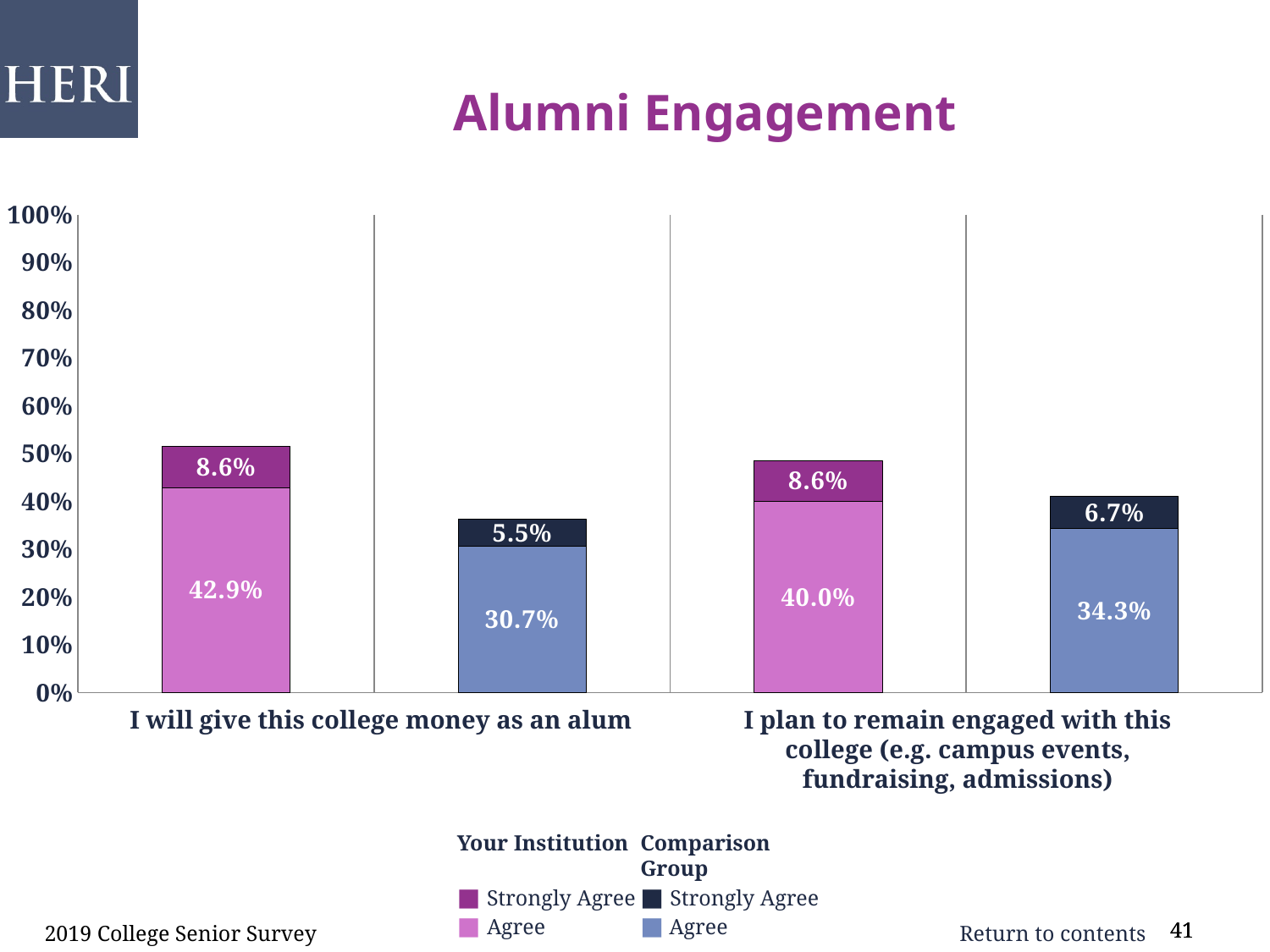
How many survey statements (categories) are shown on the x axis? 2 What is the Your Institution 'Agree' value for 'I will give this college money as an alum'? 42.9% What is the total of the Comparison Group stacked bar for 'I plan to remain engaged with this college'? 41.0% What is the total of the Your Institution stacked bar for 'I will give this college money as an alum'? 51.5% What is the Comparison Group 'Agree' value for 'I plan to remain engaged with this college'? 34.3% What kind of chart is shown on the slide? Stacked bar chart What is the title of the chart? Alumni Engagement Which is larger for 'I plan to remain engaged with this college': the Your Institution 'Agree' value or the Comparison Group 'Agree' value? Your Institution 'Agree' (40.0%) How many series does the legend list? 4 What is the Comparison Group 'Strongly Agree' value for 'I will give this college money as an alum'? 5.5% What is the difference between the Your Institution 'Agree' value and the Comparison Group 'Agree' value for 'I will give this college money as an alum'? 12.2% What is the Your Institution 'Strongly Agree' value for 'I plan to remain engaged with this college'? 8.6%